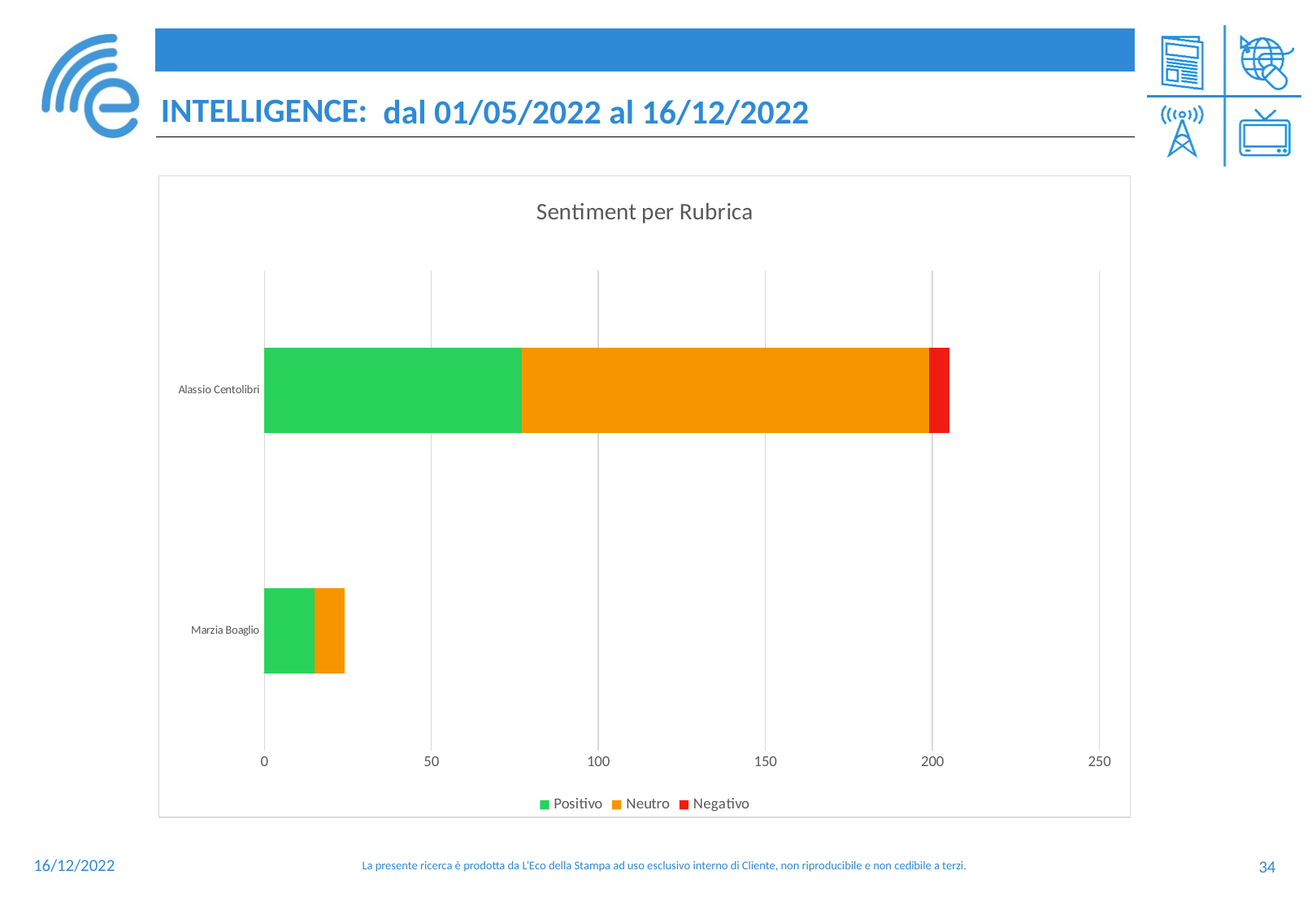
Which category has the shortest total bar? Marzia Boaglio Is the total bar for Alassio Centolibri greater or less than 200? greater Is the Positivo value for Alassio Centolibri greater or less than 100? less Which category has the longest total bar? Alassio Centolibri Which is larger for Alassio Centolibri, the Neutro segment or the Positivo segment? Neutro Is the total bar for Marzia Boaglio greater or less than 50? less What kind of chart is shown on the slide? Stacked bar chart Which series are listed in the legend? Positivo, Neutro, Negativo How many categories (rubriche) are plotted on the chart? 2 What is the title of the chart? Sentiment per Rubrica How many series does the legend list? 3